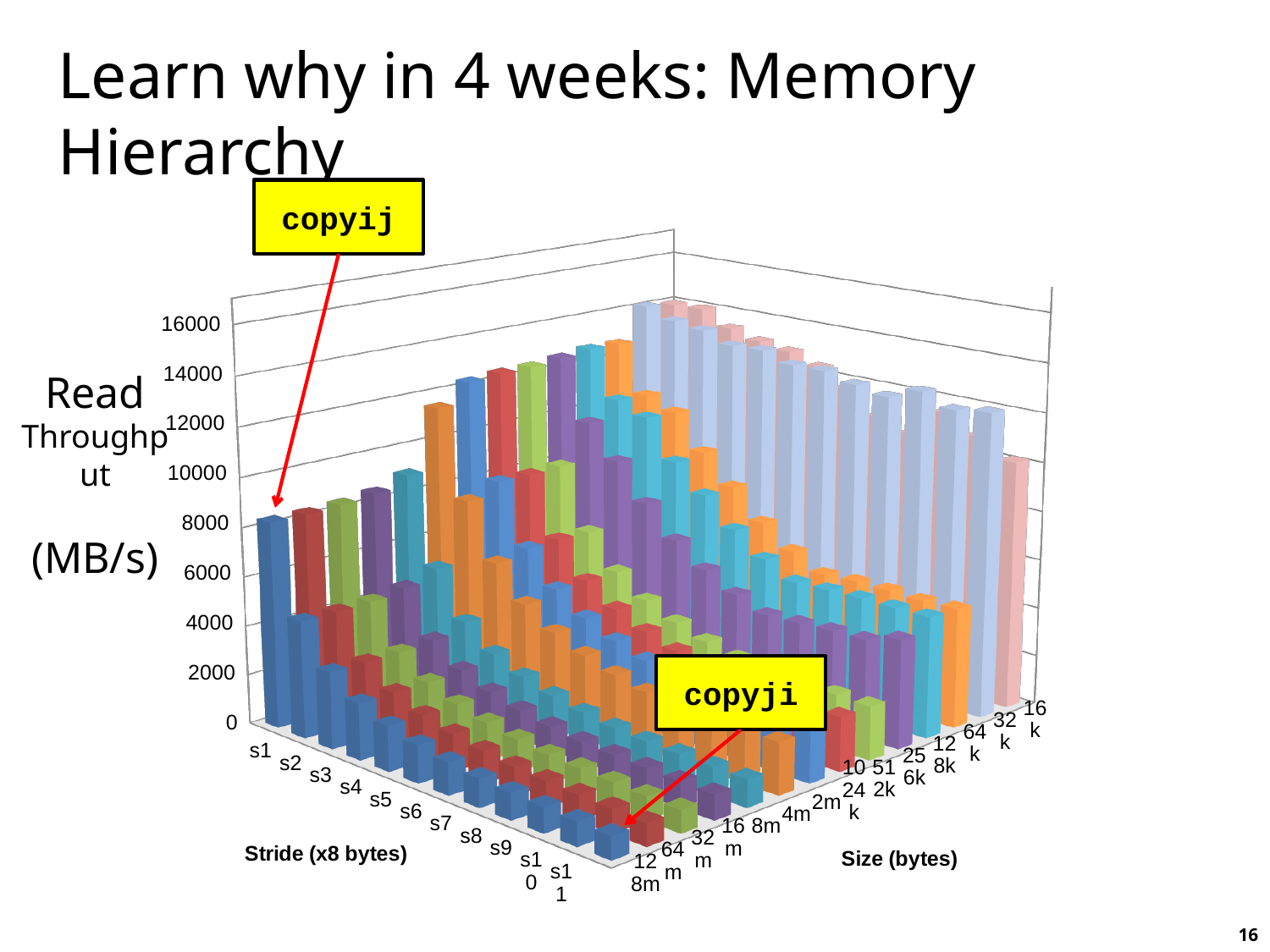
At size 128m, which stride has the higher read throughput, s1 or s2? s1 What is the label of the vertical axis of the chart? Read Throughput (MB/s) What kind of chart is shown on the slide? bar chart Is the read throughput for stride s1 at size 16k greater or less than 10000? greater How many size categories are shown along the Size (bytes) axis? 14 For size 128m, does read throughput rise or fall as the stride increases from s1 to s11? fall For stride s1, does read throughput rise or fall as the size decreases from 128m to 16k? rise What is the highest tick value shown on the vertical axis? 16000 Is the read throughput for stride s1 at size 128m greater or less than 4000? greater Is the read throughput for stride s11 at size 128m greater or less than 4000? less How many stride categories are shown along the Stride (x8 bytes) axis? 11